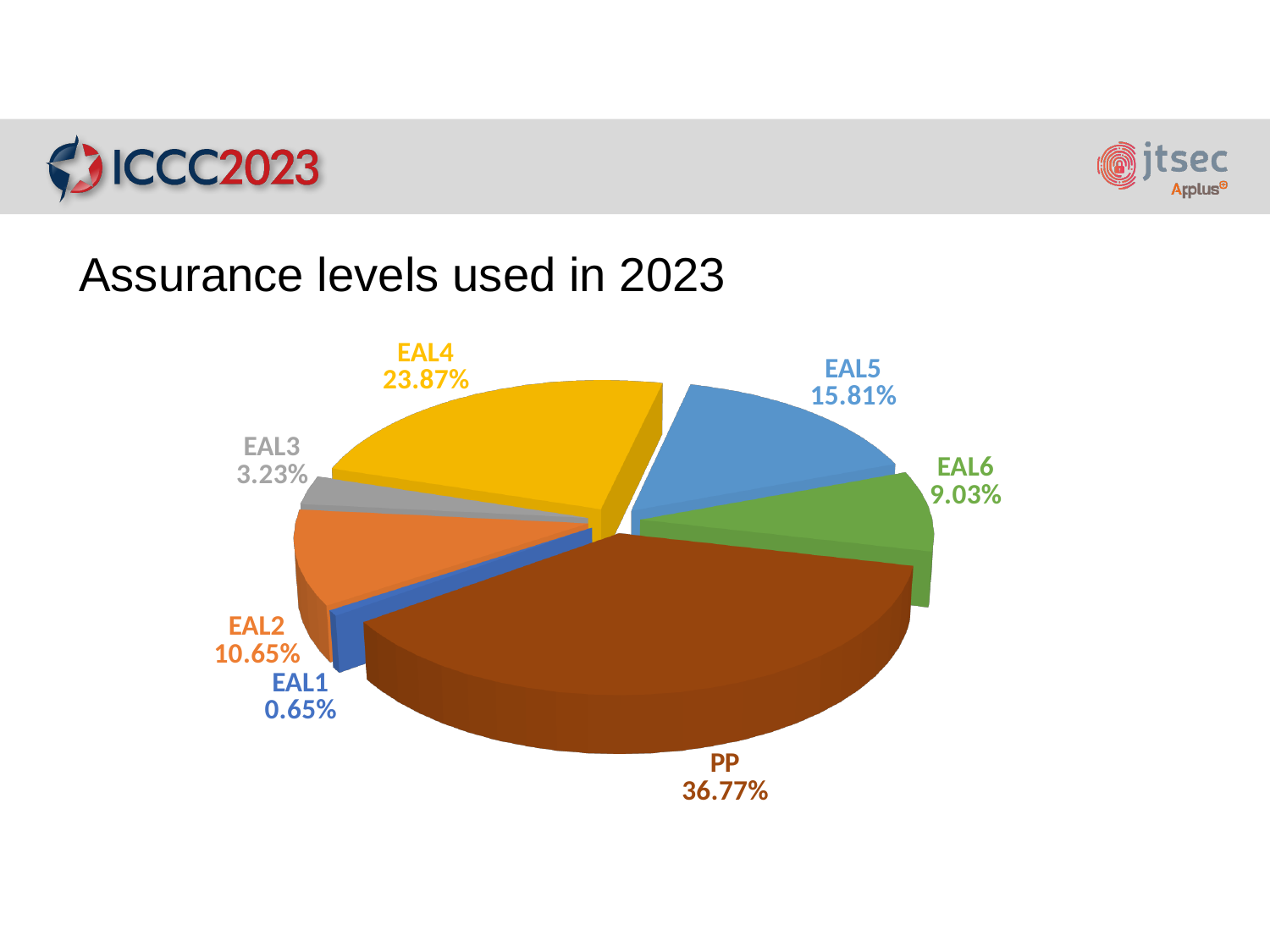
What share of the pie does PP represent? 36.77% What is the difference between the EAL4 and EAL5 shares? 8.06% What is the title of the chart on the slide? Assurance levels used in 2023 What is the value shown for EAL1? 0.65% How many categories are shown in the pie chart? 7 What is the value shown for EAL4? 23.87% Which is larger, the share for EAL2 or the share for EAL6? EAL2 What kind of chart is shown on the slide? pie chart Which category has the largest slice of the pie? PP Which category has the smallest slice of the pie? EAL1 What is the value shown for EAL5? 15.81% What is the difference between the EAL6 and EAL3 shares? 5.80%